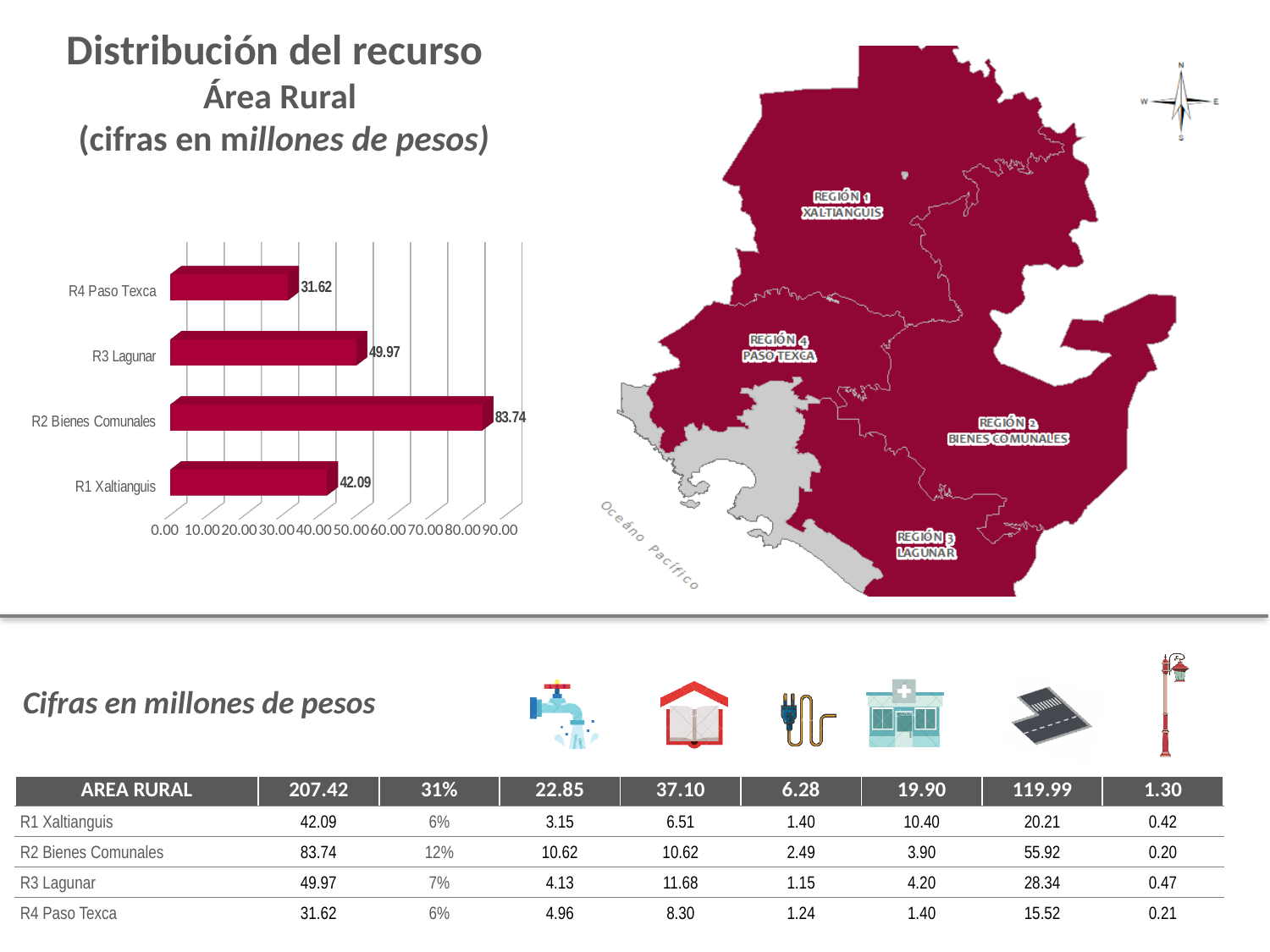
Is the value for R2 Bienes Comunales greater or less than 80.00? greater What is the value for R2 Bienes Comunales in the bar chart? 83.74 What is the value for R4 Paso Texca in the bar chart? 31.62 What is the value for R1 Xaltianguis in the bar chart? 42.09 How many categories are shown in the bar chart? 4 What is the value for R3 Lagunar in the bar chart? 49.97 Which category has the lowest value in the bar chart? R4 Paso Texca What kind of chart is shown on the slide? bar chart Which is larger in the bar chart, R3 Lagunar or R1 Xaltianguis? R3 Lagunar What is the difference between the values for R2 Bienes Comunales and R4 Paso Texca in the bar chart? 52.12 What is the maximum value shown on the horizontal axis of the bar chart? 90.00 Which category has the highest value in the bar chart? R2 Bienes Comunales